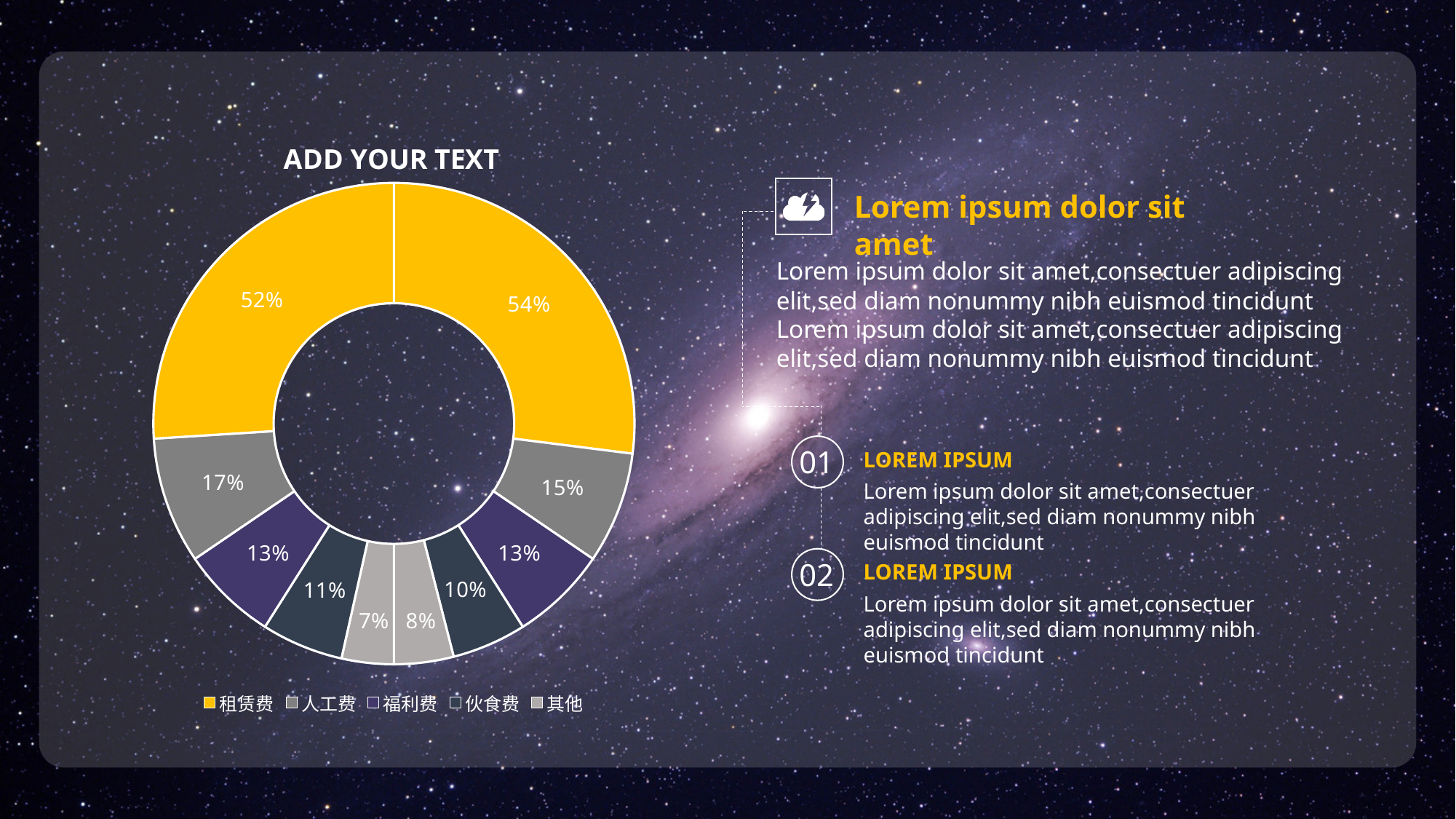
How many slices does the doughnut chart have? 10 What is the smallest percentage labelled on the chart? 7% Which colour represents 租赁费 in the legend? yellow What is the difference between the slices labelled 17% and 13%? 4 percentage points What is the value labelled on the yellow slice on the right side of the doughnut? 54% What kind of chart is shown on the slide? doughnut (pie) chart What is the title of the chart? ADD YOUR TEXT What is the largest percentage labelled on the chart? 54% How many entries does the chart's legend list? 5 What is the value labelled on the yellow slice on the left side of the doughnut? 52% Which is larger, the grey slice labelled 17% or the grey slice labelled 15%? 17% What is the difference between the two yellow slices, labelled 54% and 52%? 2 percentage points